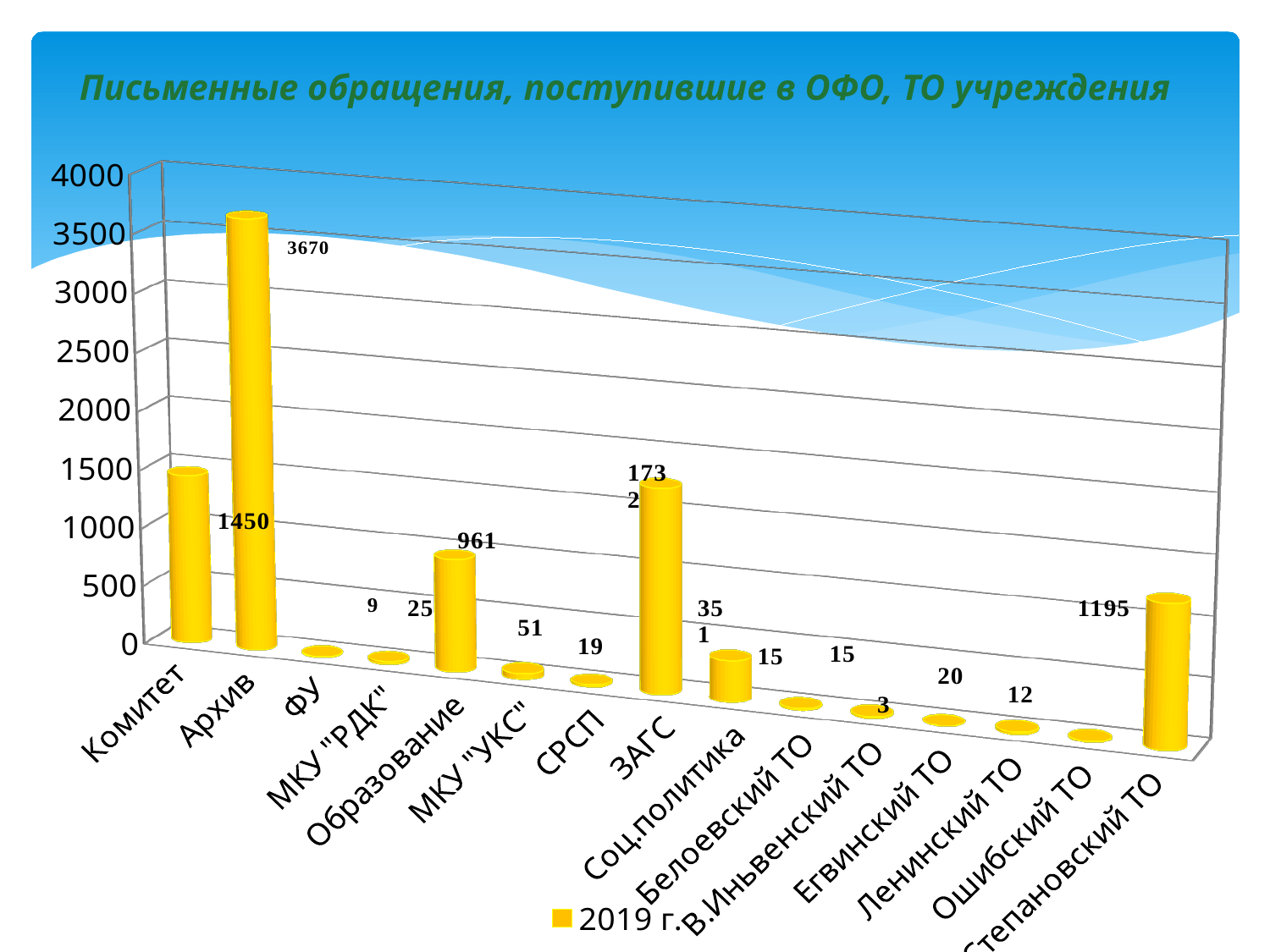
Which is larger, the value for Образование or the value for Степановский ТО? Степановский ТО How many series does the legend list? 1 What kind of chart is shown on the slide? bar chart Is the value for ЗАГС greater or less than 1500? greater Which category has the highest value? Архив What is the value for Образование? 961 What is the difference between the values for Архив and Комитет? 2220 What is the value for Степановский ТО? 1195 What is the value for Комитет? 1450 What is the value for Архив? 3670 Which category has the lowest value? Егвинский ТО How many categories are shown on the x axis? 15